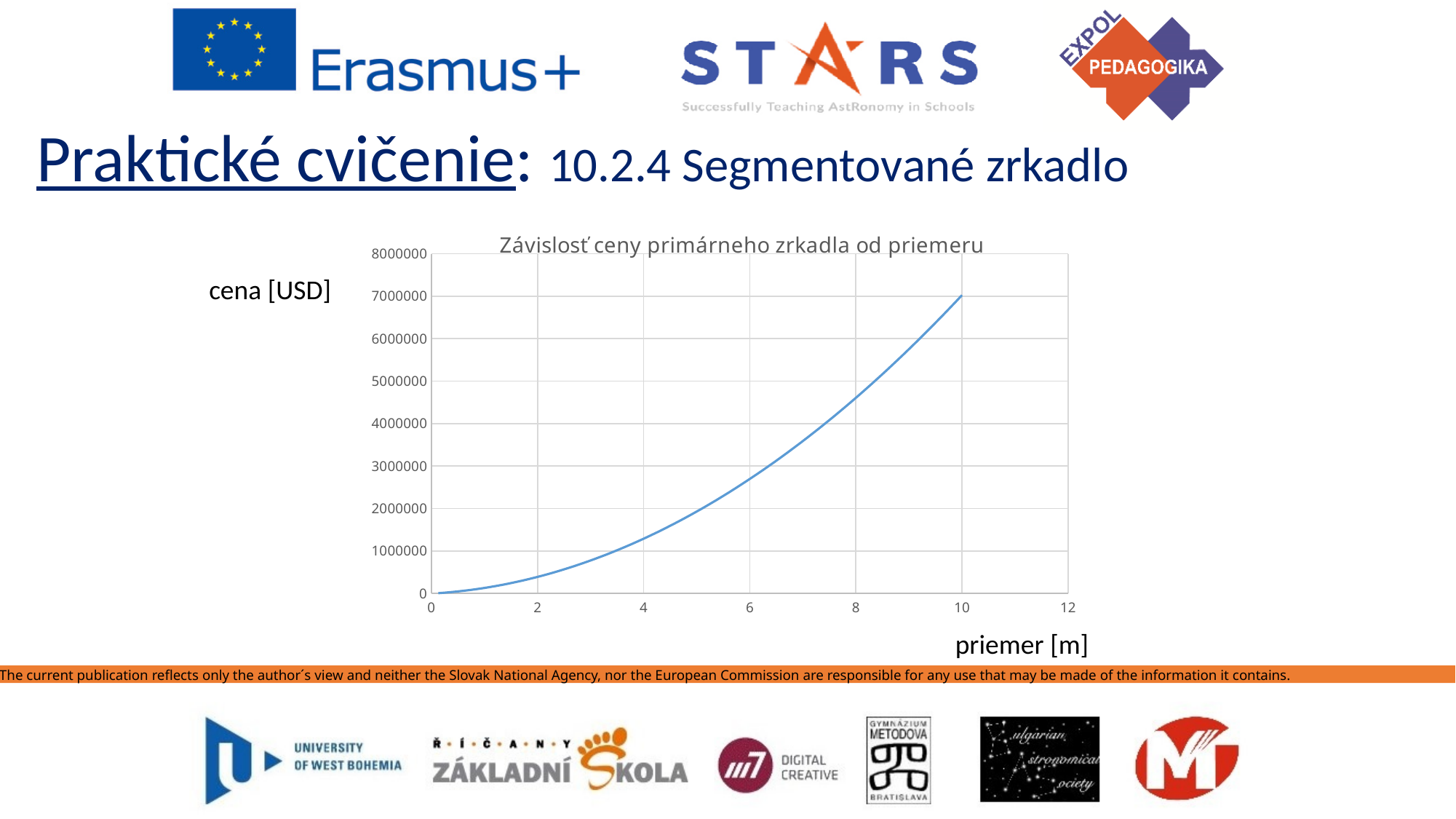
Which is larger: the price at a diameter of 8 m or at 6 m? 8 m Is the price at a diameter of 2 m greater or less than 1000000? less Is the price at a diameter of 6 m greater or less than 3000000? less What label is given to the vertical axis of the chart? cena [USD] Is the price at a diameter of 8 m greater or less than 5000000? less Does the price rise or fall as the diameter (priemer) increases along the x axis? rises What is the title of the chart? Závislosť ceny primárneho zrkadla od priemeru What kind of chart is shown on the slide? line chart What is the highest value shown on the vertical axis of the chart? 8000000